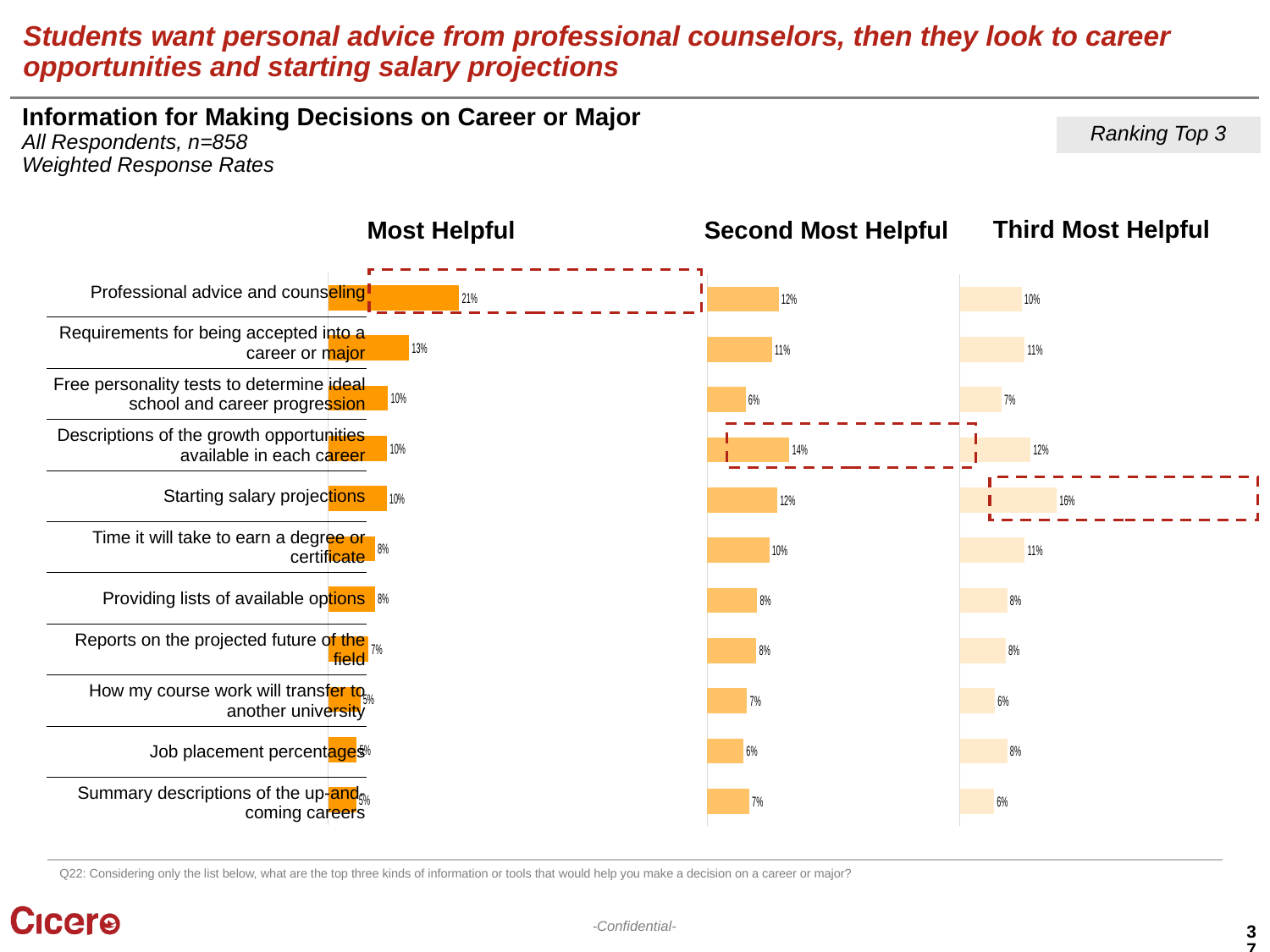
In the Second Most Helpful chart, what is the value for Descriptions of the growth opportunities available in each career? 14% How many categories are shown in the Most Helpful chart? 11 In the Third Most Helpful chart, what is the value for Starting salary projections? 16% In the Second Most Helpful chart, what is the value for Time it will take to earn a degree or certificate? 10% In the Second Most Helpful chart, which category has the highest value? Descriptions of the growth opportunities available in each career In the Third Most Helpful chart, which category has the highest value? Starting salary projections What is the sample size (n) stated in the chart subtitle? n=858 What kind of chart is the Second Most Helpful chart? Bar chart In the Most Helpful chart, what is the difference between Professional advice and counseling and Requirements for being accepted into a career or major? 8% In the Most Helpful chart, what is the value for Professional advice and counseling? 21% In the Third Most Helpful chart, which is larger: Free personality tests to determine ideal school and career progression or Job placement percentages? Job placement percentages In the Most Helpful chart, which category has the highest value? Professional advice and counseling